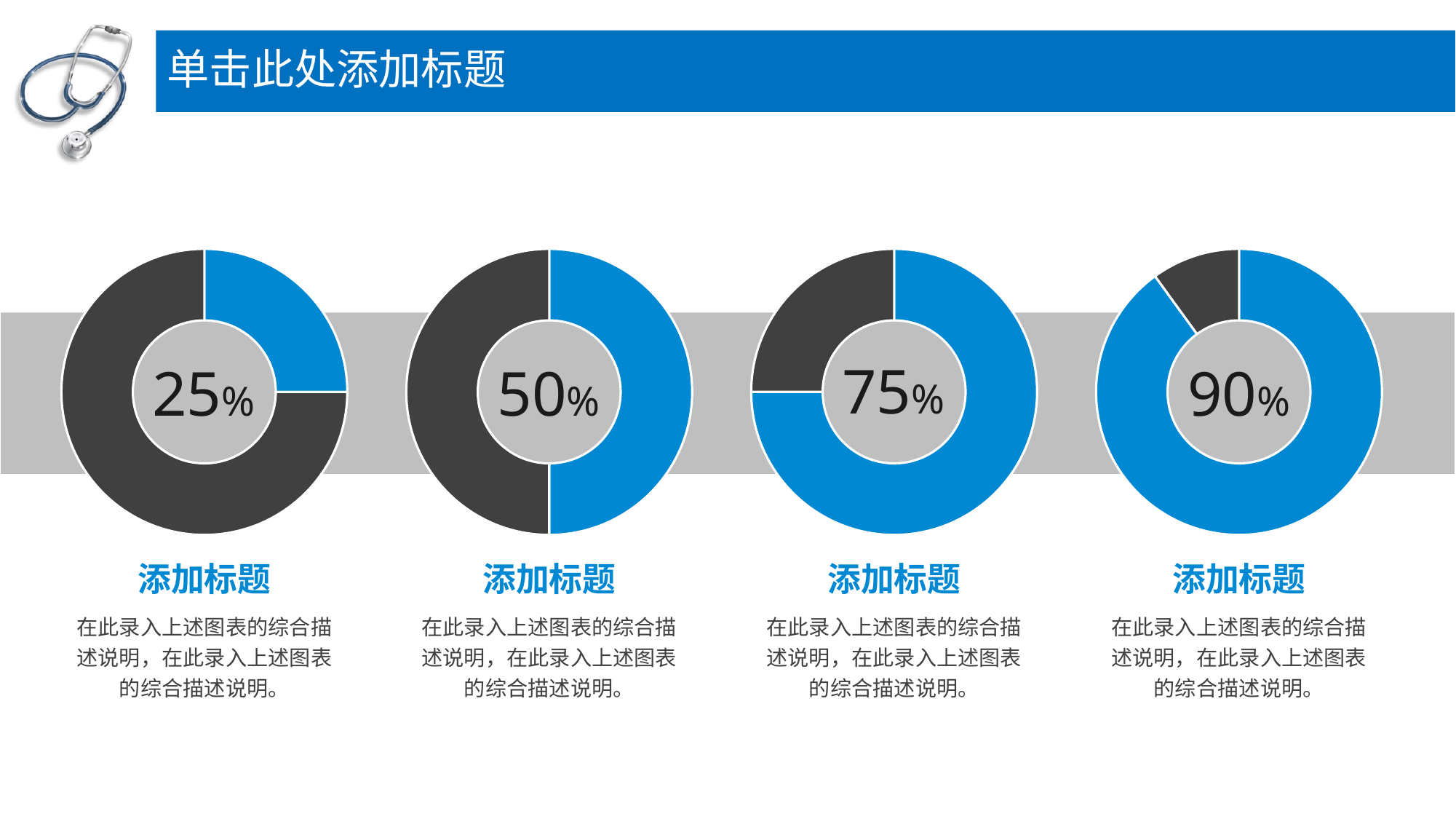
What percentage is shown in the centre of the third donut chart from the left? 75% What percentage is shown in the centre of the rightmost donut chart? 90% What percentage is shown in the centre of the leftmost donut chart? 25% In the rightmost donut chart, what share of the ring is dark grey rather than blue? 10% Which donut chart shows the lowest percentage? The leftmost chart (25%) What kind of chart is used for each of the four percentages on the slide? Donut chart What is the difference between the percentage in the rightmost donut chart and the percentage in the leftmost donut chart? 65% Which is larger: the percentage in the second donut chart from the left or the percentage in the third donut chart from the left? The third chart (75%) How many donut charts are on the slide? 4 What percentage is shown in the centre of the second donut chart from the left? 50% Do the percentages in the donut charts increase or decrease from left to right across the slide? Increase Which donut chart shows the highest percentage? The rightmost chart (90%)